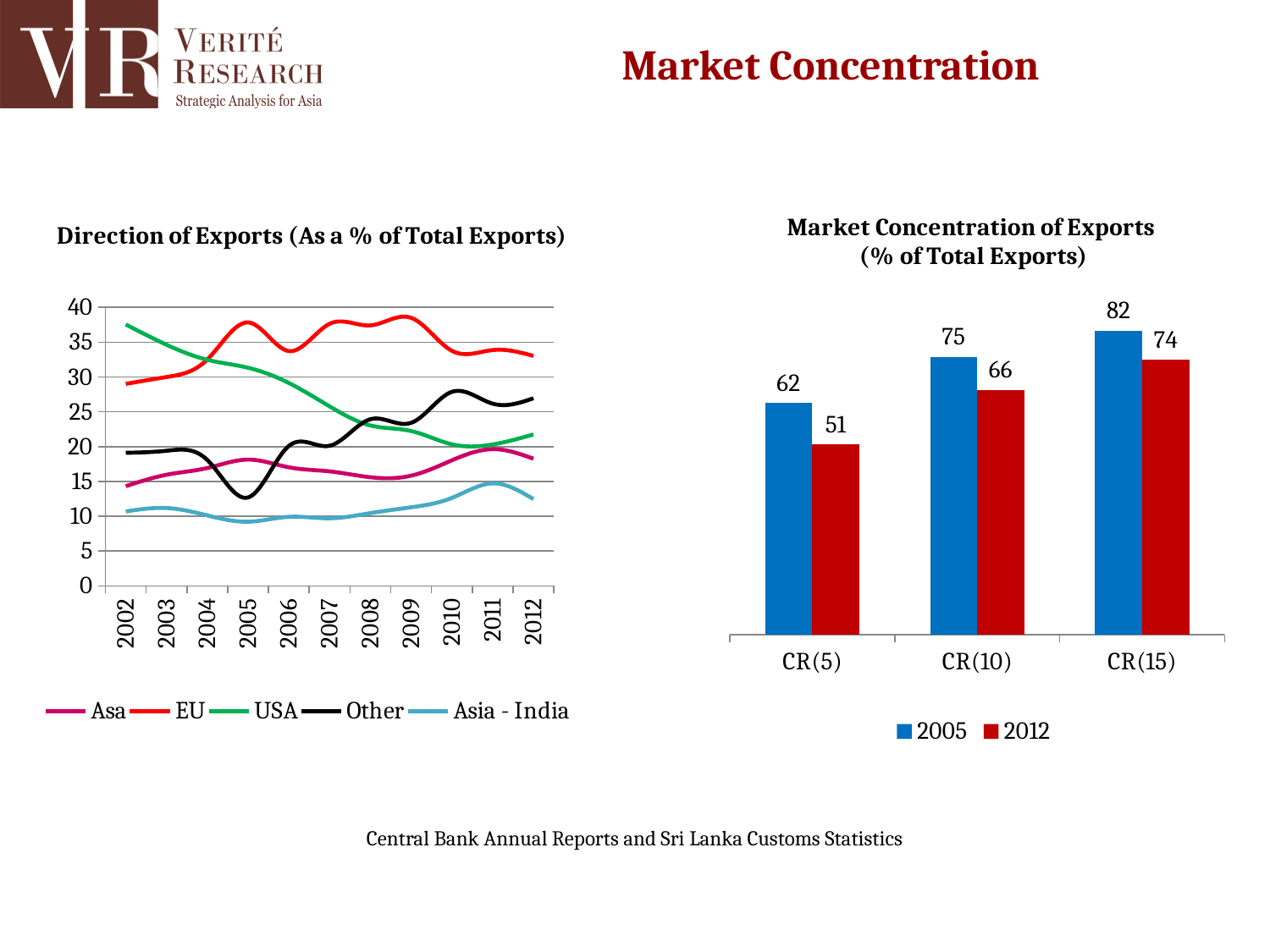
What kind of chart is the 'Direction of Exports (As a % of Total Exports)' chart? Line chart How many series does the legend of the 'Direction of Exports' chart list? 5 In the 'Direction of Exports' chart, does the USA series generally rise or fall from 2002 to 2012? Fall In the 'Market Concentration of Exports' chart, what is the 2012 value for CR(15)? 74 In the 'Market Concentration of Exports' chart, what is the difference between the 2005 and 2012 values for CR(5)? 11 In the 'Market Concentration of Exports' chart, which category has the highest 2005 value? CR(15) In the 'Market Concentration of Exports' chart, what is the 2012 value for CR(10)? 66 How many series does the legend of the 'Market Concentration of Exports' chart list? 2 In the 'Market Concentration of Exports' chart, what is the 2005 value for CR(5)? 62 In the 'Direction of Exports' chart, is the value for USA in 2002 greater or less than 35? greater In the 'Market Concentration of Exports' chart, which is larger for CR(15): the 2005 value or the 2012 value? 2005 In the 'Market Concentration of Exports' chart, which category has the lowest 2012 value? CR(5)